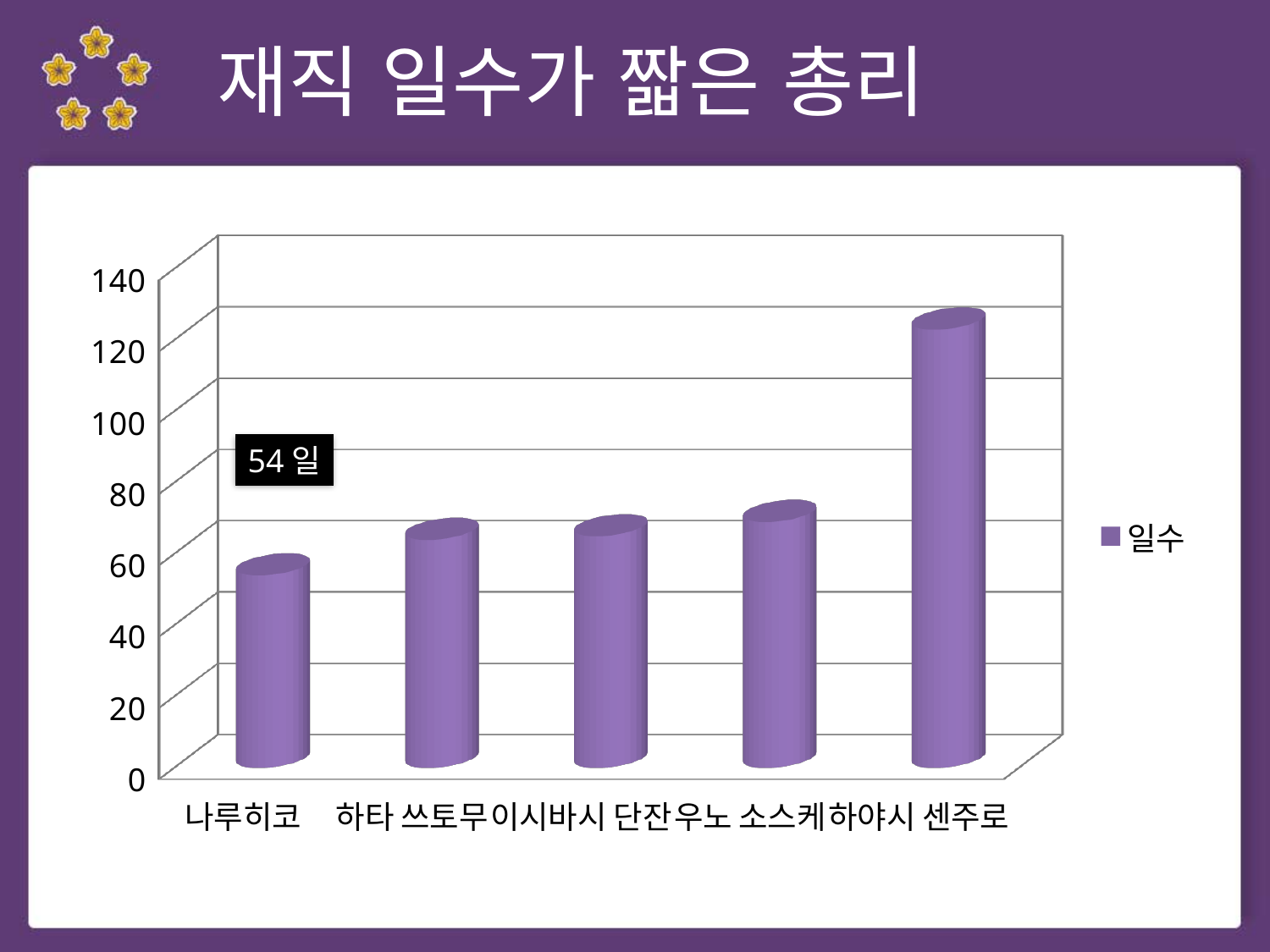
How many series does the legend list? 1 Which category has the highest value? 하야시 센주로 What is the value for 나루히코? 54 일 What is the name of the series shown in the legend? 일수 Which is larger, the value for 하타 쓰토무 or the value for 나루히코? 하타 쓰토무 Is the value for 하야시 센주로 greater or less than 100? greater What kind of chart is shown on the slide? bar chart Which is larger, the value for 하야시 센주로 or the value for 우노 소스케? 하야시 센주로 Is the value for 이시바시 단잔 greater or less than 40? greater Is the value for 우노 소스케 greater or less than 80? less How many categories are shown on the x axis? 5 Which category has the lowest value? 나루히코